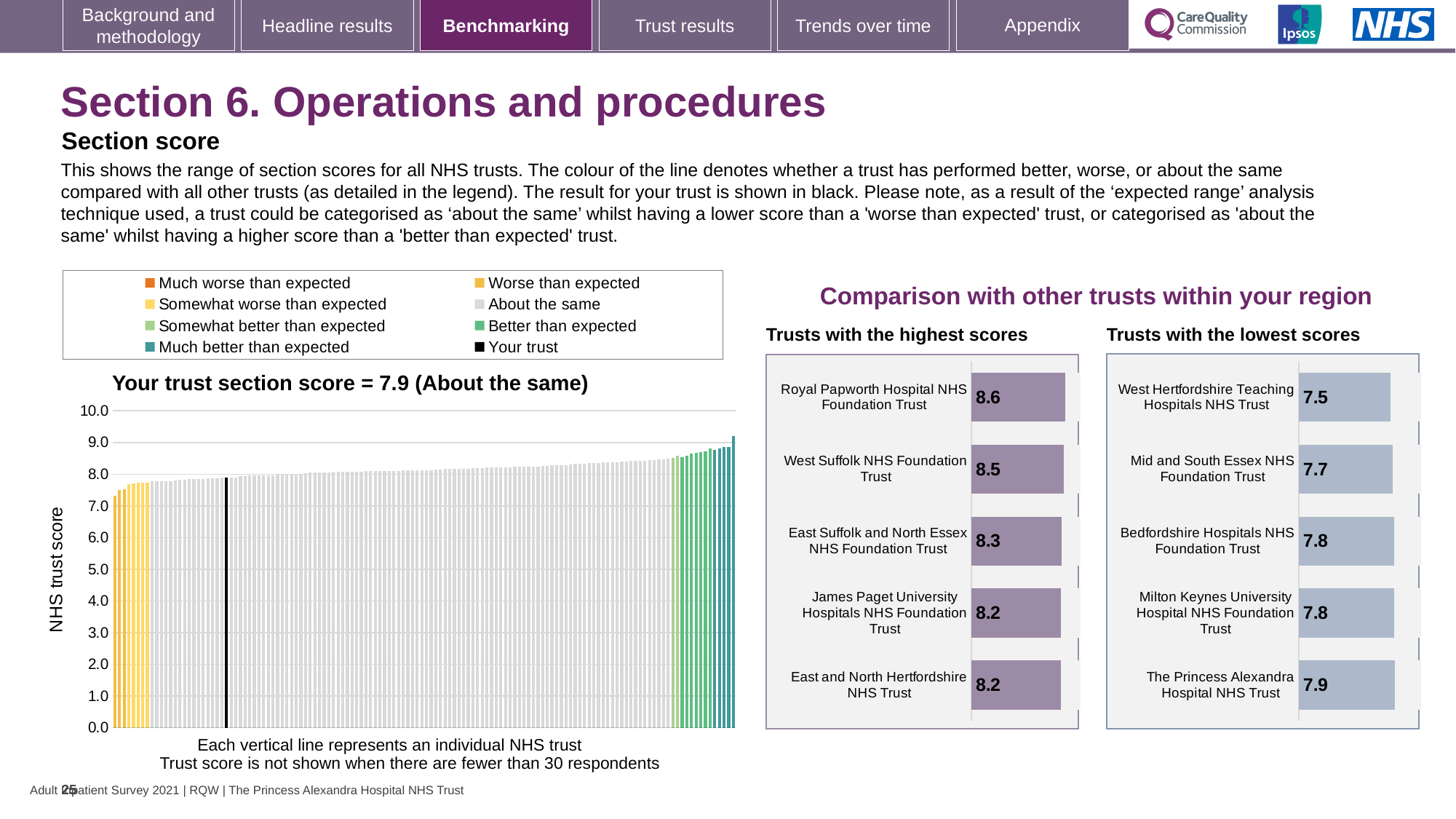
In the 'Trusts with the highest scores' chart, what is the score for Royal Papworth Hospital NHS Foundation Trust? 8.6 In the 'Trusts with the highest scores' chart, which trust has the highest score? Royal Papworth Hospital NHS Foundation Trust How many trusts are shown in the 'Trusts with the lowest scores' chart? 5 In the 'Trusts with the lowest scores' chart, what is the score for The Princess Alexandra Hospital NHS Trust? 7.9 How many entries does the legend of the main section score chart list? 8 What kind of chart is the main 'Your trust section score' chart? bar chart In the 'Trusts with the highest scores' chart, what is the difference between the scores of Royal Papworth Hospital NHS Foundation Trust and East and North Hertfordshire NHS Trust? 0.4 In the 'Trusts with the highest scores' chart, which has the higher score: West Suffolk NHS Foundation Trust or East Suffolk and North Essex NHS Foundation Trust? West Suffolk NHS Foundation Trust In the main section score chart, do the trust scores rise or fall from left to right along the x axis? rise In the 'Trusts with the lowest scores' chart, which trust has the lowest score? West Hertfordshire Teaching Hospitals NHS Trust In the 'Trusts with the lowest scores' chart, what is the score for West Hertfordshire Teaching Hospitals NHS Trust? 7.5 According to the main chart title, what is your trust's section score? 7.9